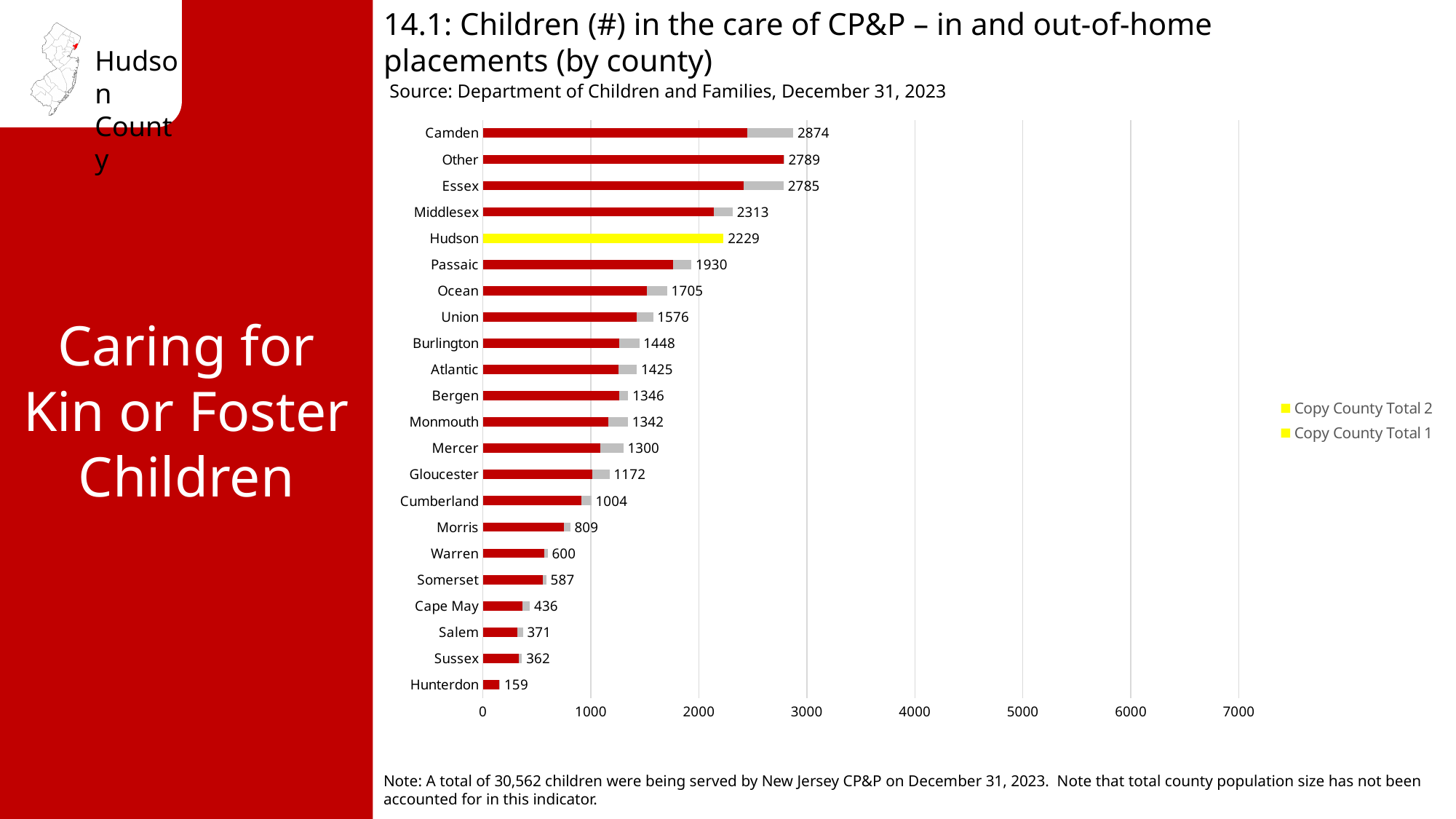
What is the value shown for Hudson? 2229 Which county has the highest value on the chart? Camden How many series does the legend list? 2 How many counties (categories) are shown on the chart? 22 What kind of chart is shown on the slide? bar chart Which has a larger value, Ocean or Union? Ocean Is the value for Morris greater or less than 1000? less Which county has the lowest value on the chart? Hunterdon What is the difference between the values for Camden and Hudson? 645 What is the total number of children in the care of CP&P for Camden? 2874 What is the value shown for Hunterdon? 159 What is the difference between the values for Essex and Middlesex? 472